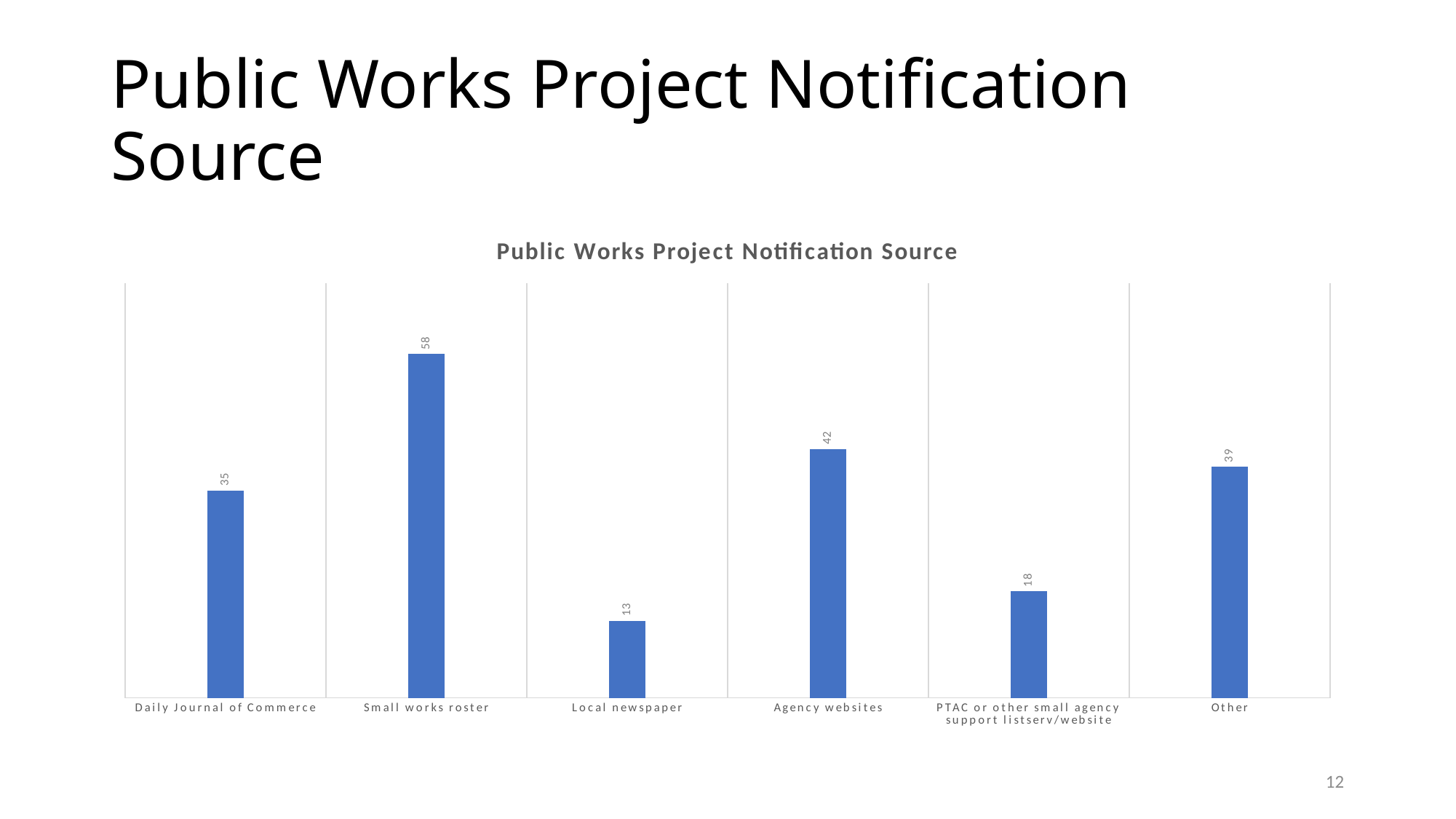
What is the difference between the values for Small works roster and Agency websites? 16 What kind of chart is shown on the slide? Bar chart What is the value for Small works roster? 58 What is the value for Other? 39 What is the title of the chart? Public Works Project Notification Source Which is larger, the value for Agency websites or the value for Other? Agency websites Which category has the highest value? Small works roster What is the value for PTAC or other small agency support listserv/website? 18 Which category has the lowest value? Local newspaper How many categories are shown on the x axis? 6 What is the value for Local newspaper? 13 What is the difference between the values for Daily Journal of Commerce and Local newspaper? 22